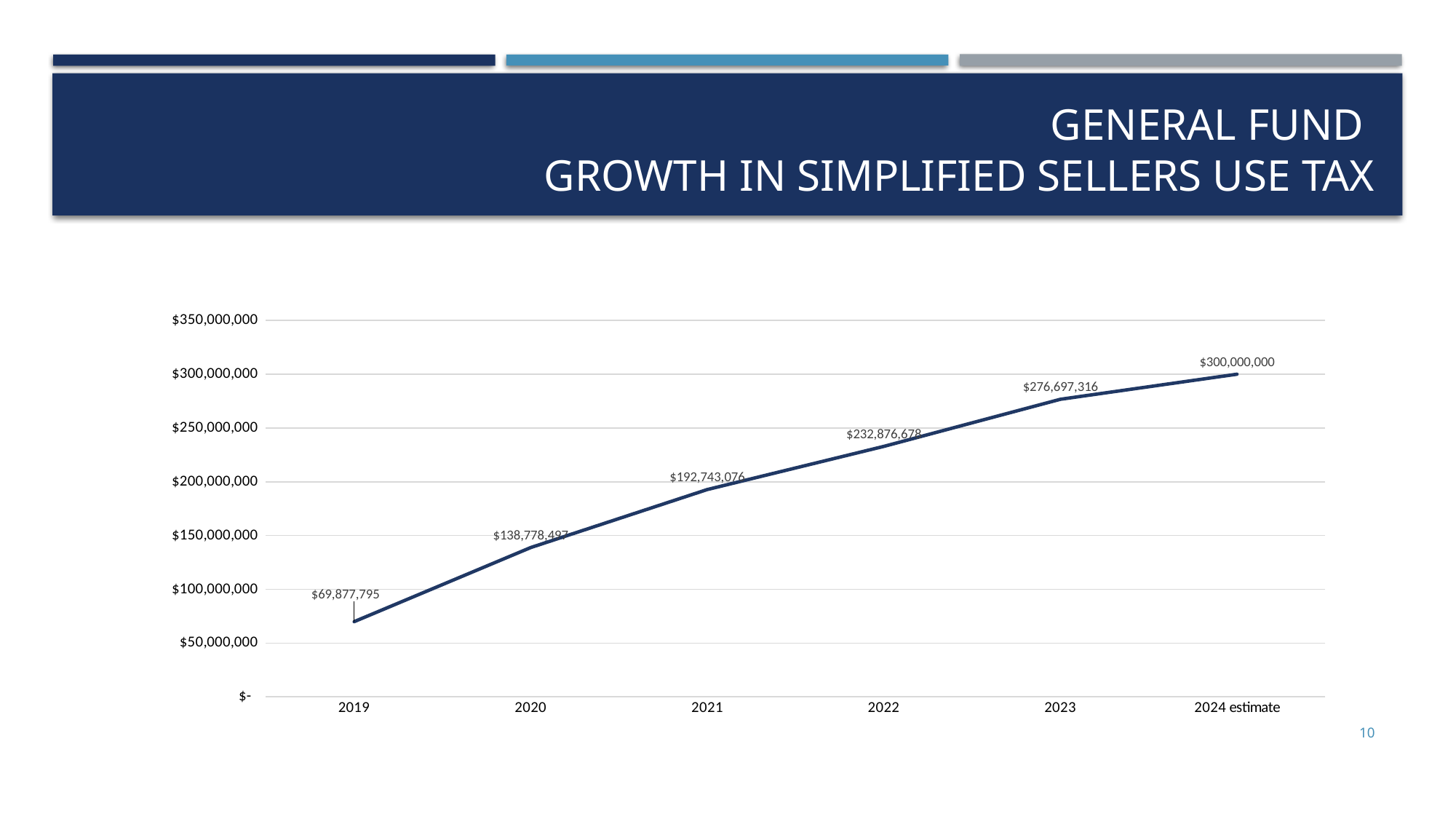
Do the values rise or fall from 2019 to the 2024 estimate? Rise What is the value for the 2024 estimate? $300,000,000 What is the value for 2023? $276,697,316 How many data points are plotted on the chart? 6 Which point on the chart has the highest value? 2024 estimate What is the difference between the 2020 value and the 2019 value? $68,900,702 What is the value for 2019? $69,877,795 What is the value for 2021? $192,743,076 What kind of chart is shown on the slide? Line chart What is the difference between the 2023 value and the 2022 value? $43,820,638 Which is larger, the value for 2021 or the value for 2022? 2022 Which year has the lowest value? 2019